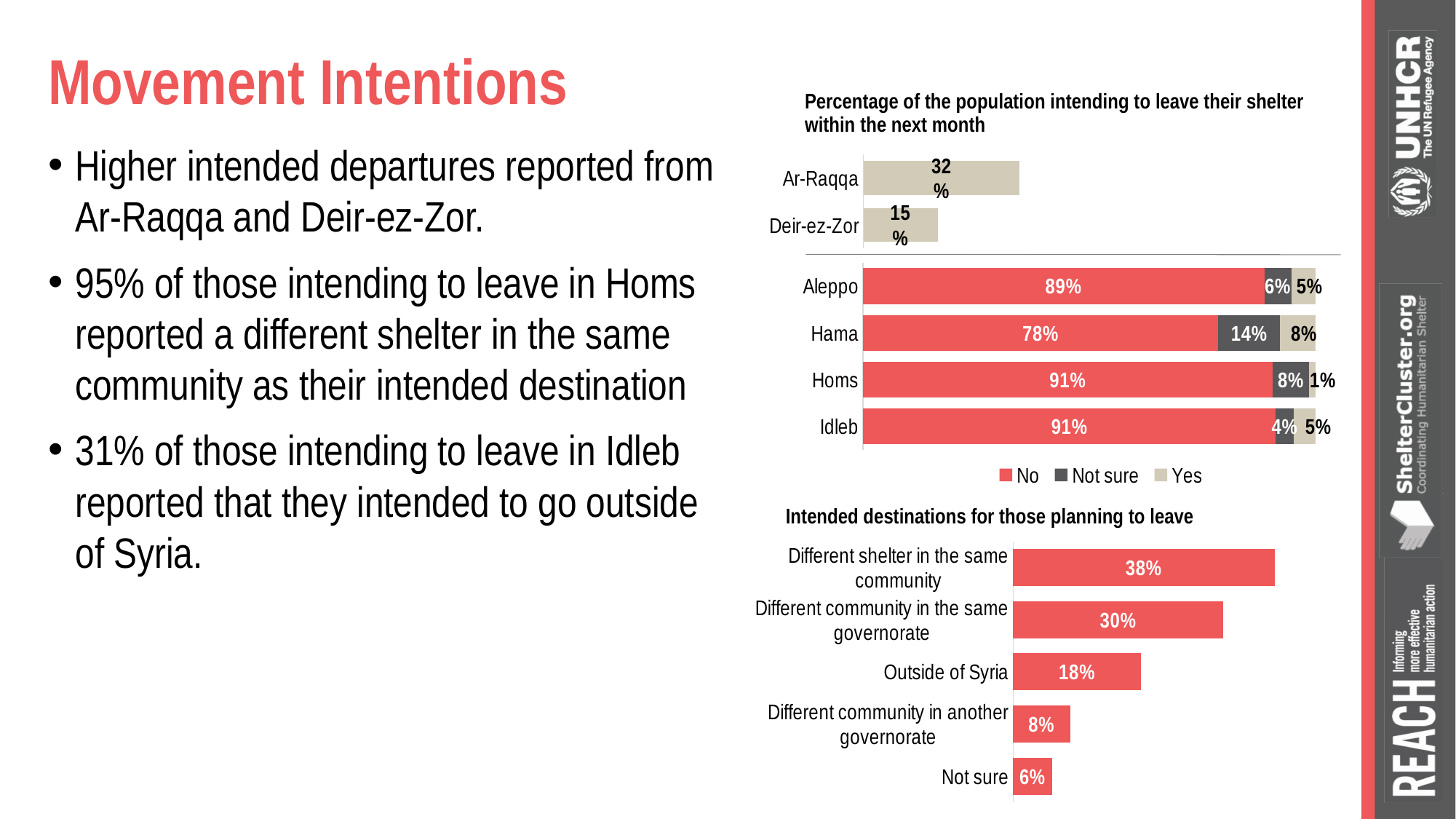
In the 'Percentage of the population intending to leave their shelter within the next month' chart, what is the value shown for Deir-ez-Zor? 15% In the 'Percentage of the population intending to leave their shelter within the next month' chart, what is the 'Yes' value for Homs? 1% In the 'Intended destinations for those planning to leave' chart, how many categories are shown? 5 In the 'Percentage of the population intending to leave their shelter within the next month' chart, which governorate has the highest 'Not sure' value among Aleppo, Hama, Homs and Idleb? Hama In the 'Intended destinations for those planning to leave' chart, what is the value for 'Outside of Syria'? 18% In the 'Percentage of the population intending to leave their shelter within the next month' chart, how many series does the legend list? 3 In the 'Intended destinations for those planning to leave' chart, which destination has the highest value? Different shelter in the same community In the 'Percentage of the population intending to leave their shelter within the next month' chart, what is the 'Not sure' value for Aleppo? 6% In the 'Percentage of the population intending to leave their shelter within the next month' chart, what is the value shown for Ar-Raqqa? 32% In the 'Percentage of the population intending to leave their shelter within the next month' chart, what is the difference between the 'No' values for Homs and Hama? 13% In the 'Intended destinations for those planning to leave' chart, which category has the lowest value? Not sure In the 'Percentage of the population intending to leave their shelter within the next month' chart, what is the 'No' value for Hama? 78%